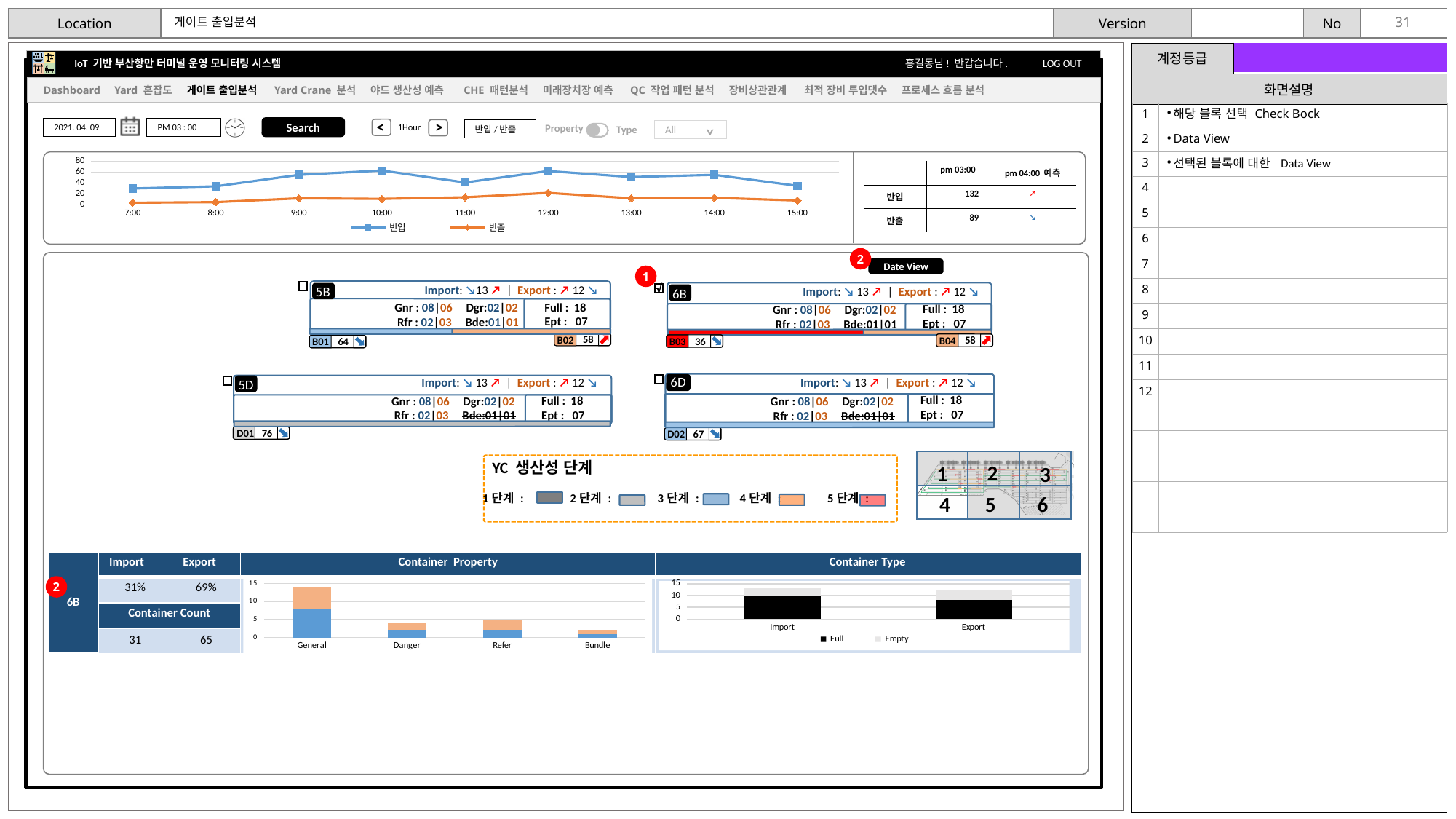
In the top line chart, is the 반출 value at 12:00 greater or less than 40? less In the top line chart, which series has the larger value at 12:00, 반입 or 반출? 반입 In the top line chart, how many series does the legend list? 2 In the Container Property chart, which category has the highest total? General In the Container Type chart, is the total for Import greater or less than 10? greater What kind of chart is the chart at the top of the slide showing 반입 and 반출 by hour? line chart In the Container Property chart, is the total for General greater or less than 10? greater In the top line chart, how many time points are plotted along the x axis? 9 In the Container Type chart, how many series does the legend list? 2 What kind of chart is the Container Property chart? bar chart In the Container Property chart, which category has the lowest total? Bundle